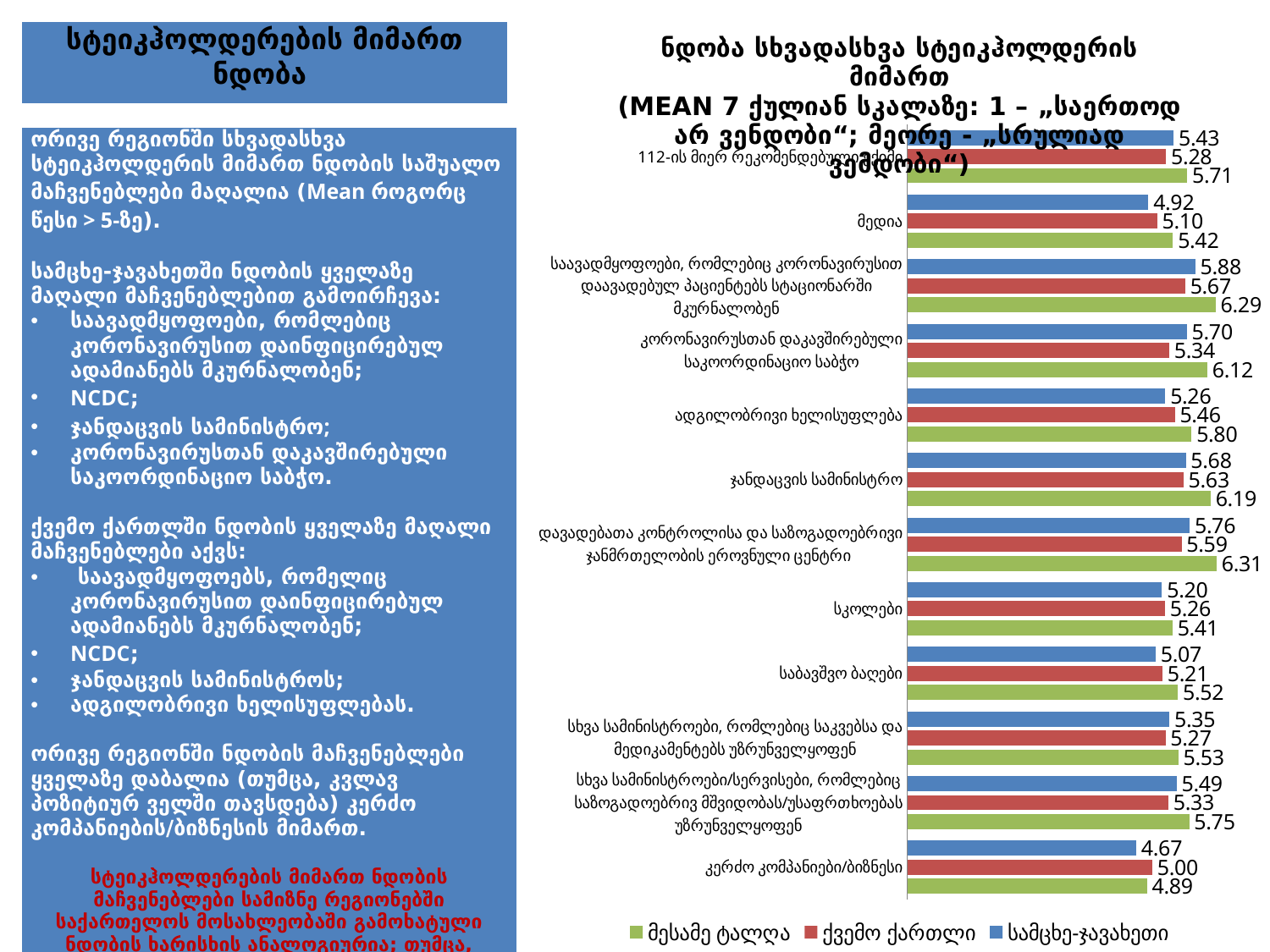
How many series does the chart legend list? 3 Which category has the highest value in the ქვემო ქართლი series? საავადმყოფოები, რომლებიც კორონავირუსით დაავადებულ პაციენტებს სტაციონარში მკურნალობენ Which category has the highest value in the მესამე ტალღა series? დავადებათა კონტროლისა და საზოგადოებრივი ჯანმრთელობის ეროვნული ცენტრი What is the value for საბავშვო ბაღები in the მესამე ტალღა series? 5.52 For ადგილობრივი ხელისუფლება, which is larger: the ქვემო ქართლი value or the სამცხე-ჯავახეთი value? ქვემო ქართლი What is the value for ჯანდაცვის სამინისტრო in the მესამე ტალღა series? 6.19 Which category has the lowest value in the სამცხე-ჯავახეთი series? კერძო კომპანიები/ბიზნესი What is the difference between the მესამე ტალღა and სამცხე-ჯავახეთი values for კორონავირუსთან დაკავშირებული საკოორდინაციო საბჭო? 0.42 What is the value for სკოლები in the ქვემო ქართლი series? 5.26 Which series is shown in green in the chart? მესამე ტალღა What is the value for მედია in the სამცხე-ჯავახეთი series? 4.92 What type of chart is shown on the slide? bar chart